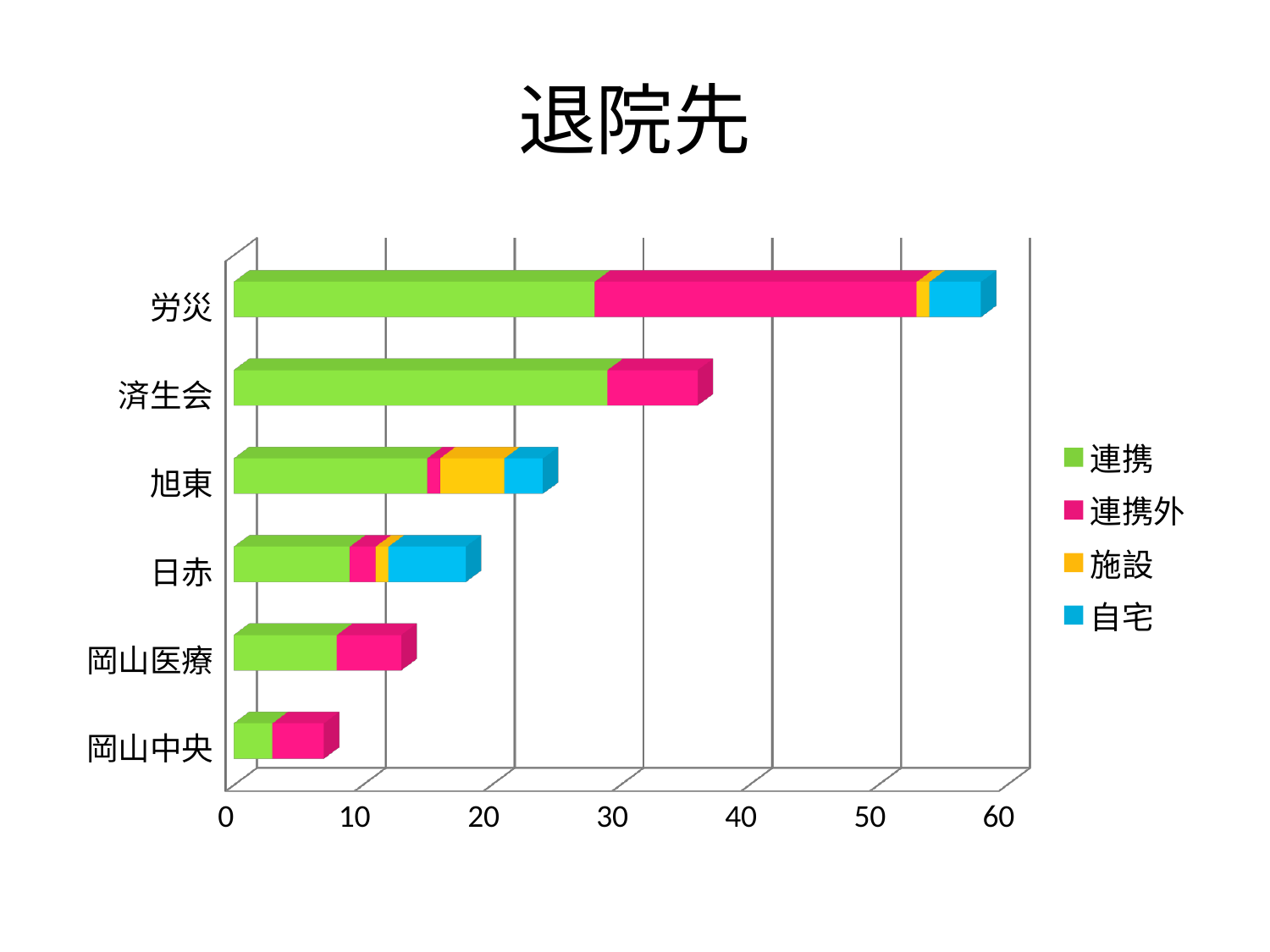
Is the total bar length for 労災 greater or less than 50? greater Which category has the longest total bar? 労災 Which has a longer total bar, 済生会 or 旭東? 済生会 Which series is shown in green in the legend? 連携 Which category has the shortest total bar? 岡山中央 How many series does the legend list? 4 What kind of chart is shown on the slide? bar chart Is the total bar length for 旭東 greater or less than 20? greater What is the title of the chart? 退院先 Is the total bar length for 岡山中央 greater or less than 10? less How many categories (hospitals) are shown on the chart? 6